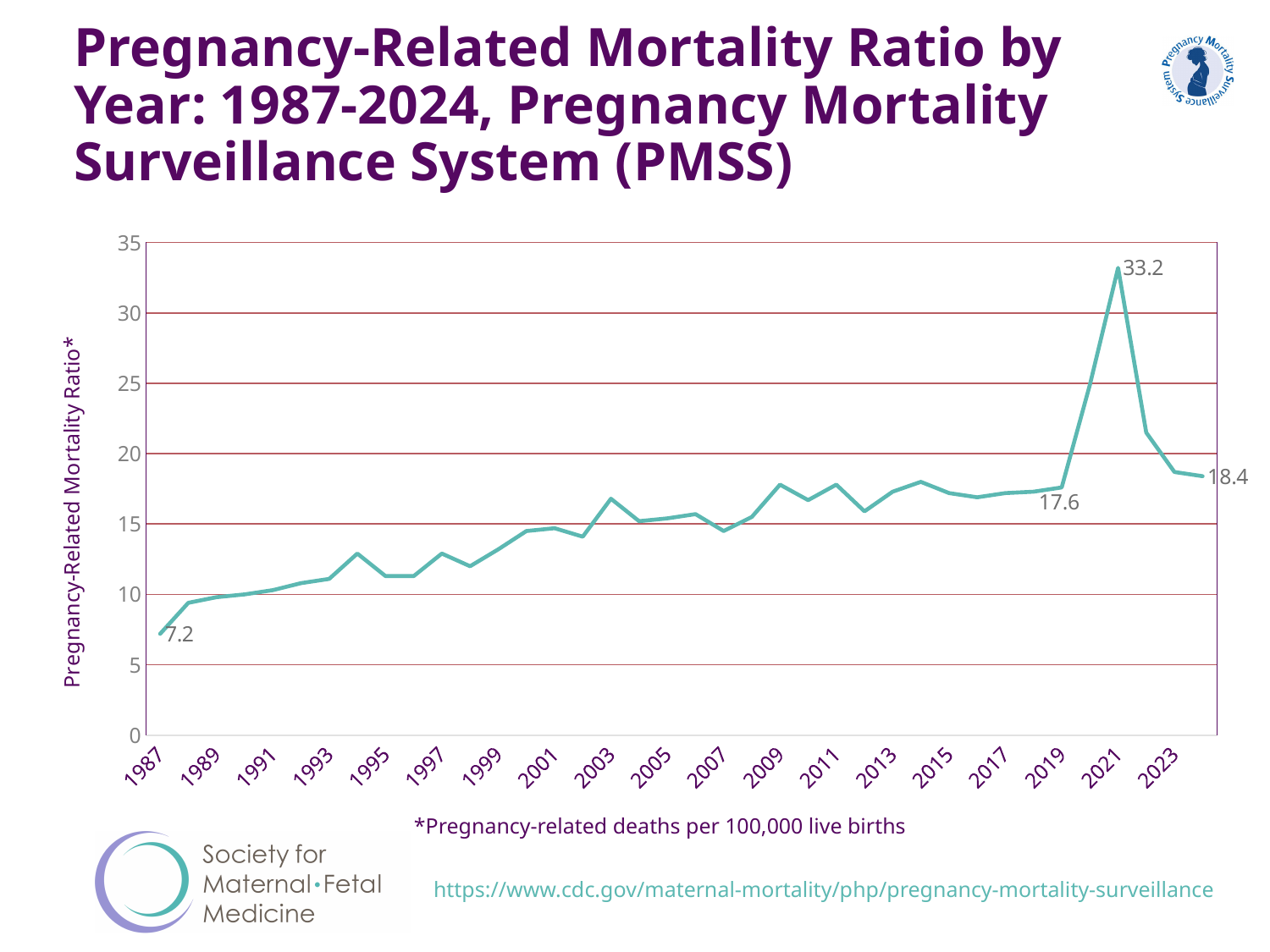
What is the difference between the 2021 value and the 1987 value? 26.0 Is the value for 1995 greater or less than 15? less What is the difference between the 2021 value and the 2019 value? 15.6 Is the value for 2009 greater or less than 15? greater What is the pregnancy-related mortality ratio for 1987? 7.2 What value is labeled at the final point of the line (2024)? 18.4 In which year is the pregnancy-related mortality ratio lowest? 1987 What is the pregnancy-related mortality ratio for 2019? 17.6 What is the label on the vertical axis? Pregnancy-Related Mortality Ratio* In which year is the pregnancy-related mortality ratio highest? 2021 What kind of chart is shown on the slide? line chart What is the pregnancy-related mortality ratio for 2021? 33.2